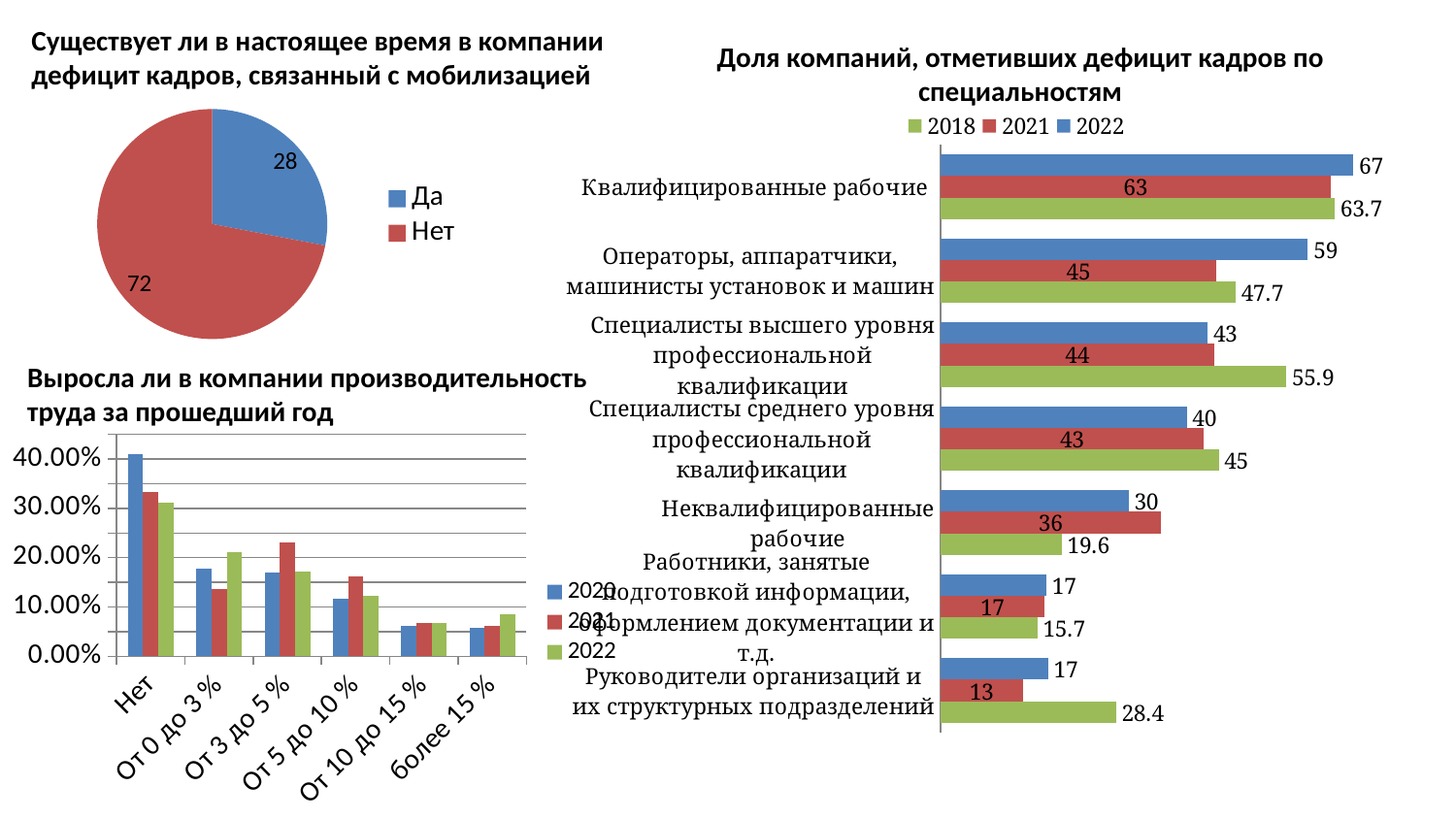
In the right chart "Доля компаний, отметивших дефицит кадров по специальностям", what is the difference between the 2022 and 2021 values for "Операторы, аппаратчики, машинисты установок и машин"? 14 In the right chart "Доля компаний, отметивших дефицит кадров по специальностям", which category has the highest 2022 value? Квалифицированные рабочие What kind of chart is the top-left chart titled "Существует ли в настоящее время в компании дефицит кадров, связанный с мобилизацией"? pie chart In the bottom-left chart "Выросла ли в компании производительность труда за прошедший год", is the 2020 value for "Нет" greater or less than 30.00%? greater In the top-left pie chart, what is the value for "Да"? 28 In the right chart "Доля компаний, отметивших дефицит кадров по специальностям", which is larger for "Неквалифицированные рабочие": the 2021 value or the 2018 value? 2021 How many categories are shown on the x axis of the bottom-left chart "Выросла ли в компании производительность труда за прошедший год"? 6 How many series does the legend of the right chart "Доля компаний, отметивших дефицит кадров по специальностям" list? 3 In the right chart "Доля компаний, отметивших дефицит кадров по специальностям", what is the 2018 value for "Руководители организаций и их структурных подразделений"? 28.4 In the right chart "Доля компаний, отметивших дефицит кадров по специальностям", what is the 2022 value for "Квалифицированные рабочие"? 67 In the right chart "Доля компаний, отметивших дефицит кадров по специальностям", which category has the lowest 2021 value? Руководители организаций и их структурных подразделений In the top-left pie chart, what share of the pie does "Нет" take? 72